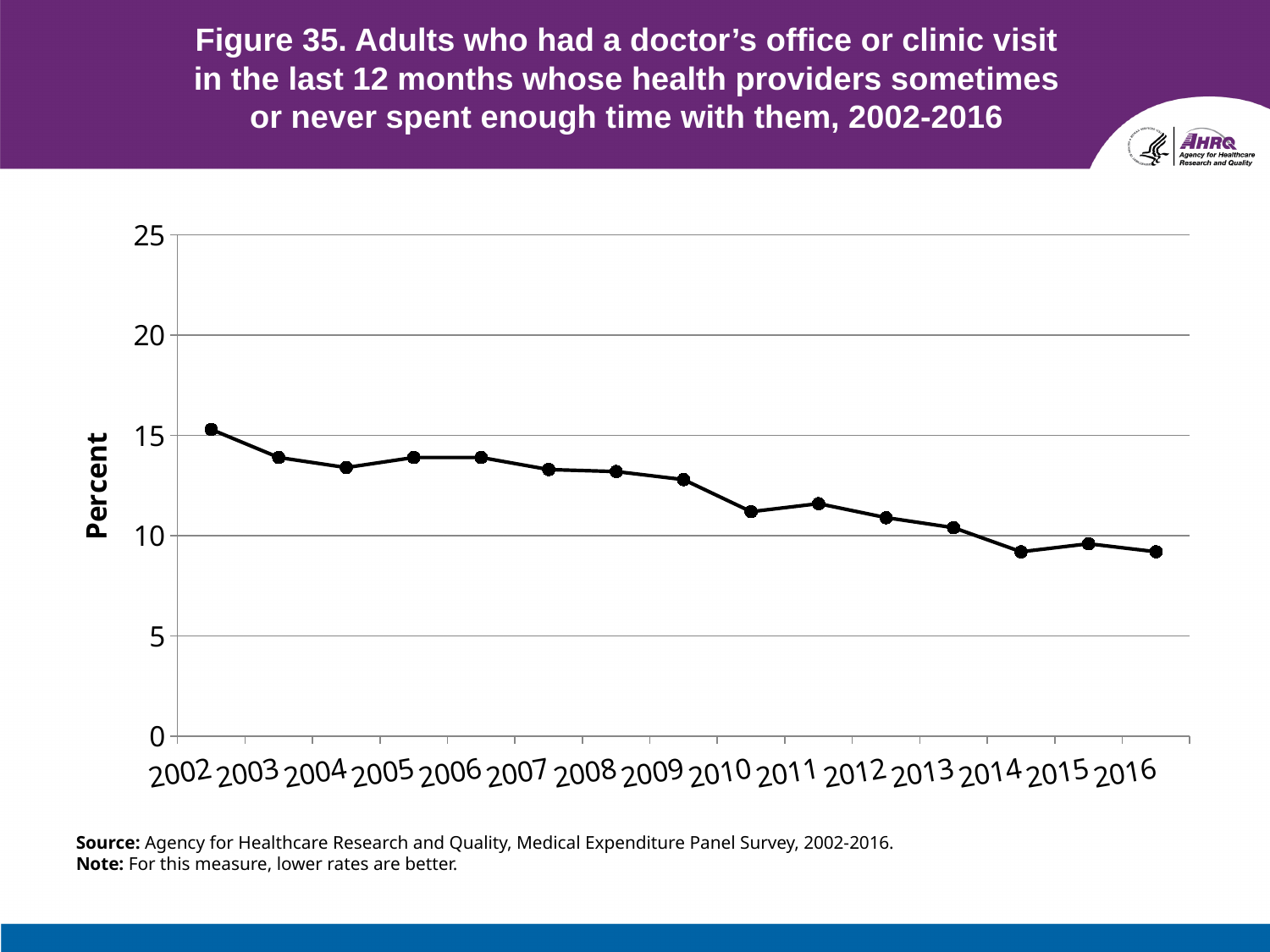
How many years are plotted along the x axis? 15 Is the value for 2002 greater or less than 15? greater Is the value for 2009 greater or less than 10? greater Which is larger, the value for 2011 or the value for 2013? 2011 What is the label on the vertical axis? Percent Which is larger, the value for 2002 or the value for 2016? 2002 Which is larger, the value for 2009 or the value for 2010? 2009 What kind of chart is shown on the slide? line chart Do the values generally rise or fall from 2002 to 2016? fall Which year has the highest value? 2002 Is the value for 2003 greater or less than 15? less